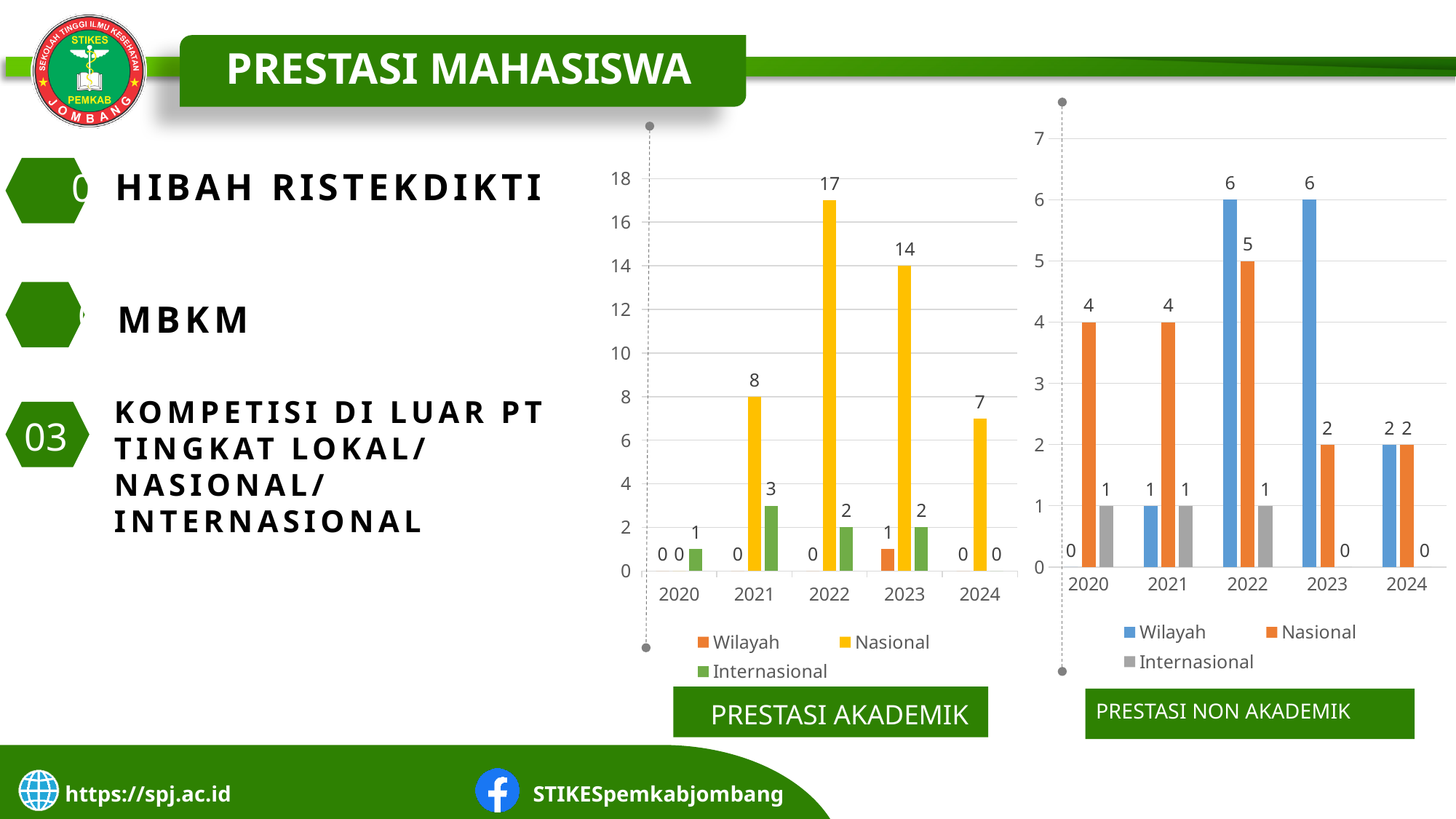
In the PRESTASI NON AKADEMIK chart, which is larger, the Wilayah value for 2023 or the Nasional value for 2023? Wilayah In the PRESTASI AKADEMIK chart, what is the Internasional value for 2021? 3 In the PRESTASI AKADEMIK chart, how many series does the legend list? 3 In the PRESTASI NON AKADEMIK chart, what is the Wilayah value for 2022? 6 In the PRESTASI NON AKADEMIK chart, what is the Nasional value for 2020? 4 In the PRESTASI NON AKADEMIK chart, what colour represents the Internasional series? Grey In the PRESTASI AKADEMIK chart, which year has the highest Nasional value? 2022 In the PRESTASI AKADEMIK chart, what is the difference between the Nasional values for 2022 and 2023? 3 In the PRESTASI AKADEMIK chart, what is the Nasional value for 2022? 17 In the PRESTASI AKADEMIK chart, how many years are shown on the x axis? 5 In the PRESTASI NON AKADEMIK chart, what is the difference between the Nasional values for 2022 and 2024? 3 What type of chart is the PRESTASI NON AKADEMIK chart? Bar chart